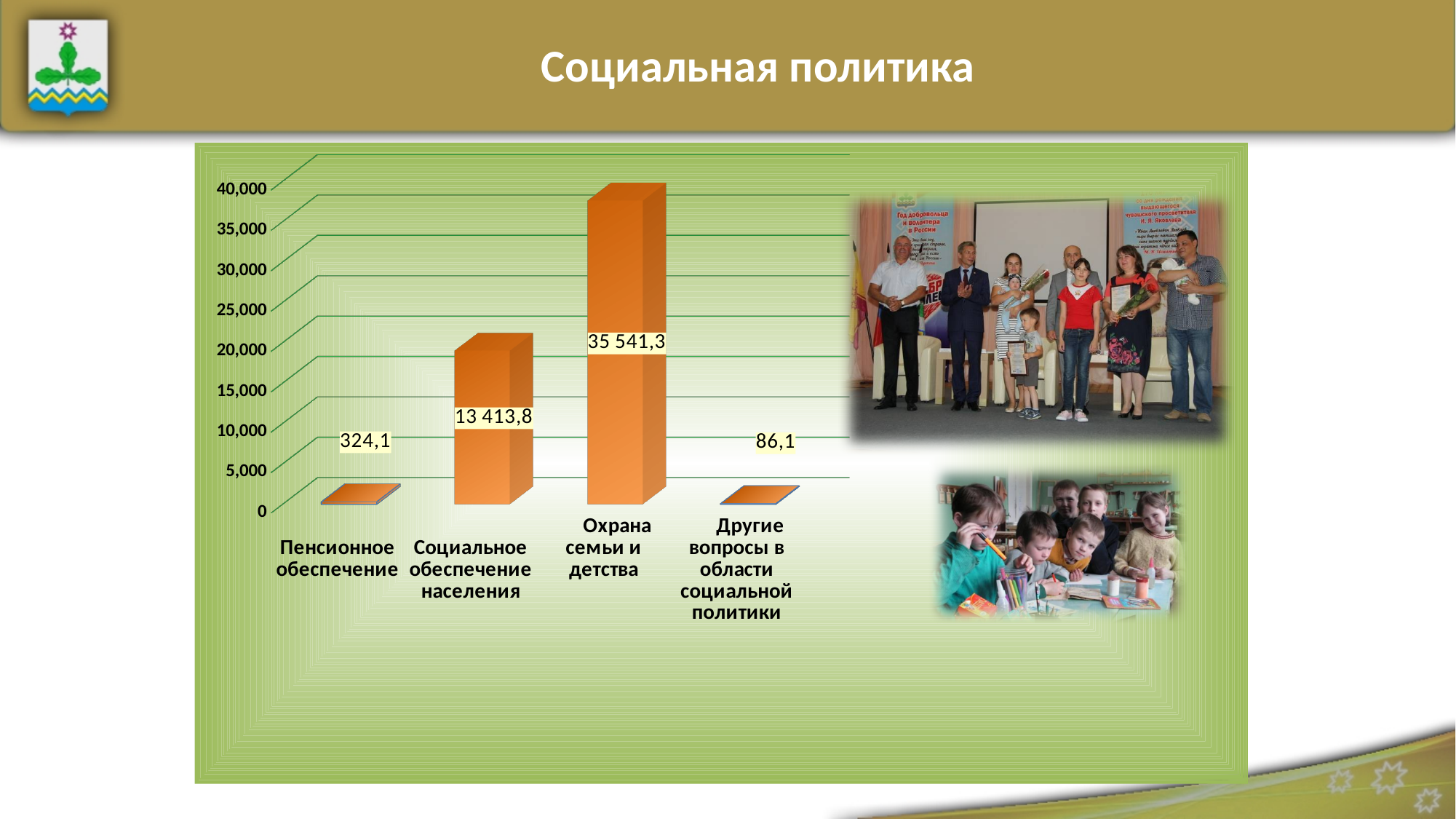
Is the value for Социальное обеспечение населения greater or less than 10,000? greater What is the value for Пенсионное обеспечение? 324,1 What is the value for Охрана семьи и детства? 35 541,3 What is the difference between the values for Пенсионное обеспечение and Другие вопросы в области социальной политики? 238,0 Which category has the lowest value? Другие вопросы в области социальной политики What kind of chart is shown on the slide? bar chart What is the value for Другие вопросы в области социальной политики? 86,1 What is the difference between the values for Охрана семьи и детства and Социальное обеспечение населения? 22 127,5 Which category has the highest value? Охрана семьи и детства How many categories are shown in the chart? 4 Which is larger, the value for Пенсионное обеспечение or the value for Социальное обеспечение населения? Социальное обеспечение населения What is the value for Социальное обеспечение населения? 13 413,8